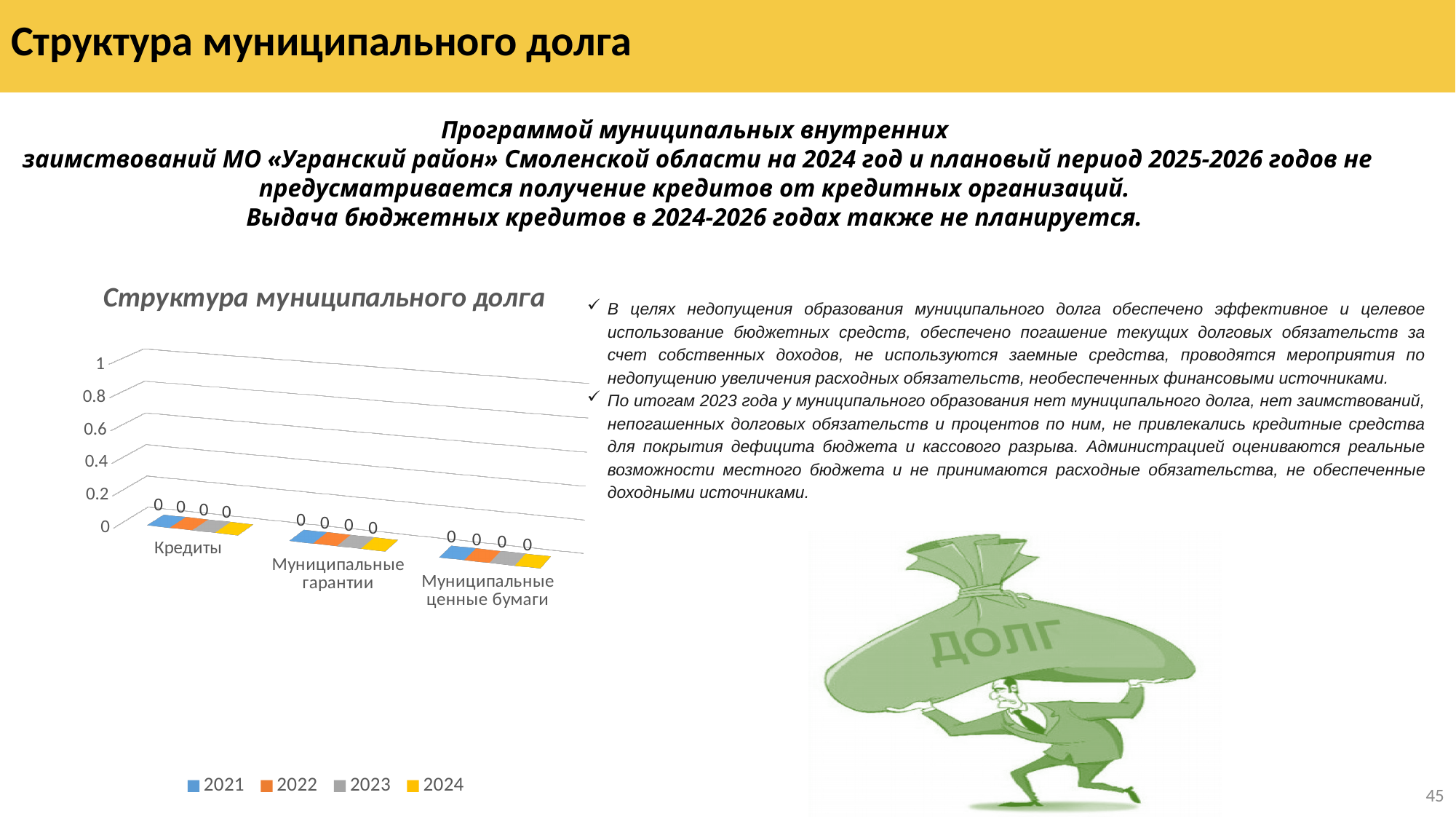
What is the value for Муниципальные гарантии in 2023? 0 What is the title of the chart on the slide? Структура муниципального долга What is the value for Кредиты in 2022? 0 How many series does the chart legend list? 4 What is the value for Кредиты in 2021? 0 What is the value for Муниципальные ценные бумаги in 2024? 0 Is the value for Муниципальные ценные бумаги in 2022 greater or less than 0.2? less What is the difference between the 2024 value for Кредиты and the 2024 value for Муниципальные гарантии? 0 What is the highest value shown on the chart's vertical axis? 1 What kind of chart is shown on the slide? bar chart How many categories are shown on the x axis of the chart? 3 Which years are listed in the chart legend? 2021, 2022, 2023, 2024